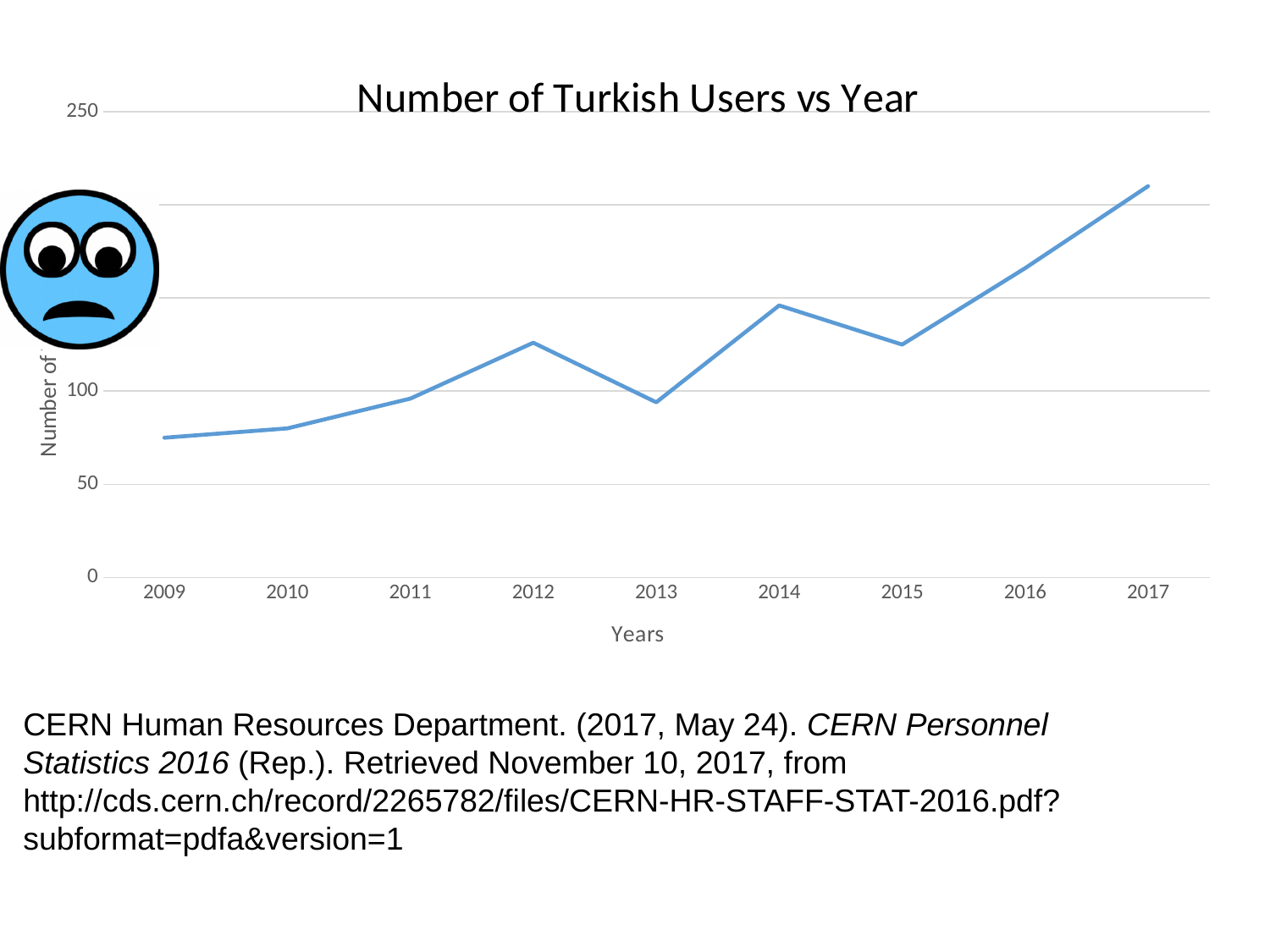
Which year has the highest number of Turkish users? 2017 Is the value for 2012 greater or less than 100? greater Which year has the larger value, 2014 or 2015? 2014 What kind of chart is shown on the slide? line chart Which year has the larger value, 2012 or 2013? 2012 Is the value for 2017 greater or less than 250? less What is the title of the chart? Number of Turkish Users vs Year Overall, does the number of Turkish users rise or fall from 2009 to 2017? rise Is the value for 2014 greater or less than 100? greater How many years are plotted on the x axis? 9 What is the label on the x axis of the chart? Years